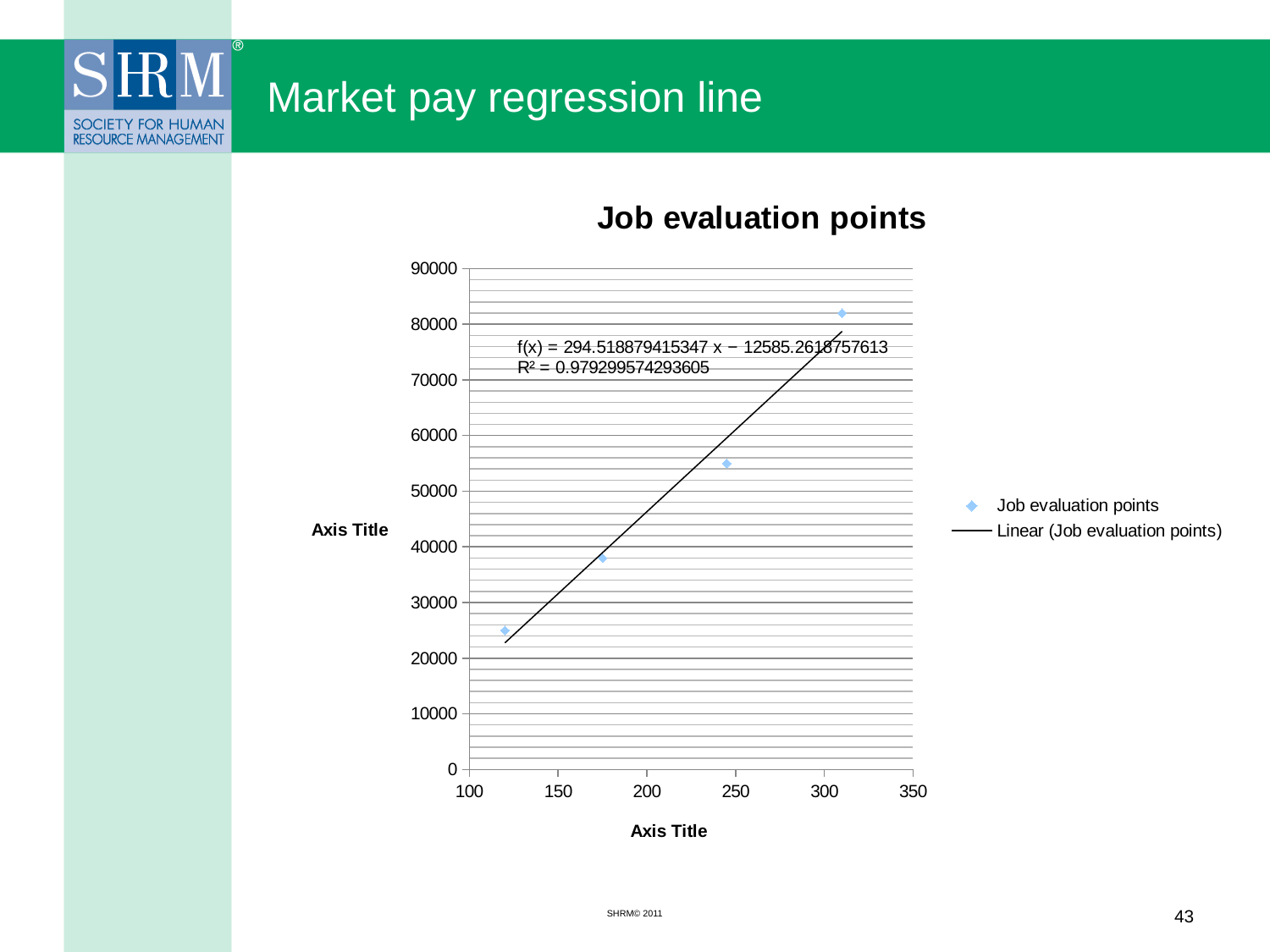
Is the value of the data point at the far left of the chart (near x = 120) greater or less than 30000? less What kind of chart is shown on the slide? Scatter chart How many data points are plotted in the Job evaluation points chart? 4 Is the value of the data point at the far right of the chart (near x = 310) greater or less than 70000? greater What R² value is printed on the chart? R² = 0.979299574293605 Which data point has the highest value: the one near x = 120 or the one near x = 310? The one near x = 310 What is the title of the chart? Job evaluation points Is the value of the data point near x = 245 greater or less than 50000? greater How many entries does the legend of the chart list? 2 What is the maximum value shown on the y-axis of the chart? 90000 Do the plotted values rise or fall as the x-axis value increases? Rise